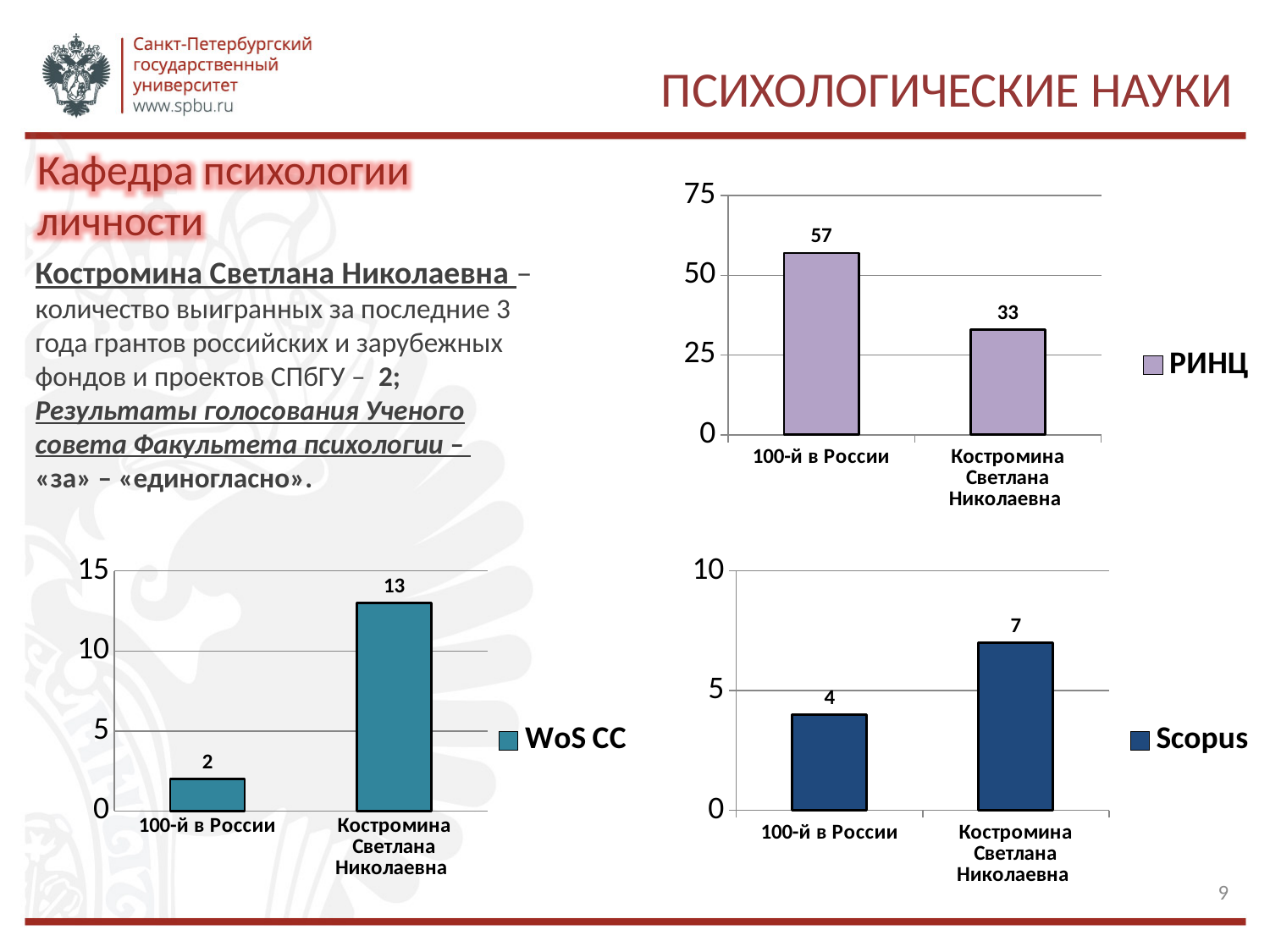
In the Scopus chart (bottom right), is the value for Костромина Светлана Николаевна greater or less than 5? greater In the РИНЦ chart (top right), what is the value for Костромина Светлана Николаевна? 33 In the WoS CC chart (bottom left), which category has the lowest value? 100-й в России In the Scopus chart (bottom right), what is the value for 100-й в России? 4 In the РИНЦ chart (top right), what is the value for 100-й в России? 57 In the РИНЦ chart (top right), which is larger: the value for 100-й в России or the value for Костромина Светлана Николаевна? 100-й в России In the РИНЦ chart (top right), what is the difference between the value for 100-й в России and the value for Костромина Светлана Николаевна? 24 How many categories are shown in the WoS CC chart (bottom left)? 2 In the WoS CC chart (bottom left), what is the value for Костромина Светлана Николаевна? 13 In the WoS CC chart (bottom left), what is the difference between the two bars? 11 In the Scopus chart (bottom right), which category has the highest value? Костромина Светлана Николаевна What type of chart is the Scopus chart (bottom right)? bar chart